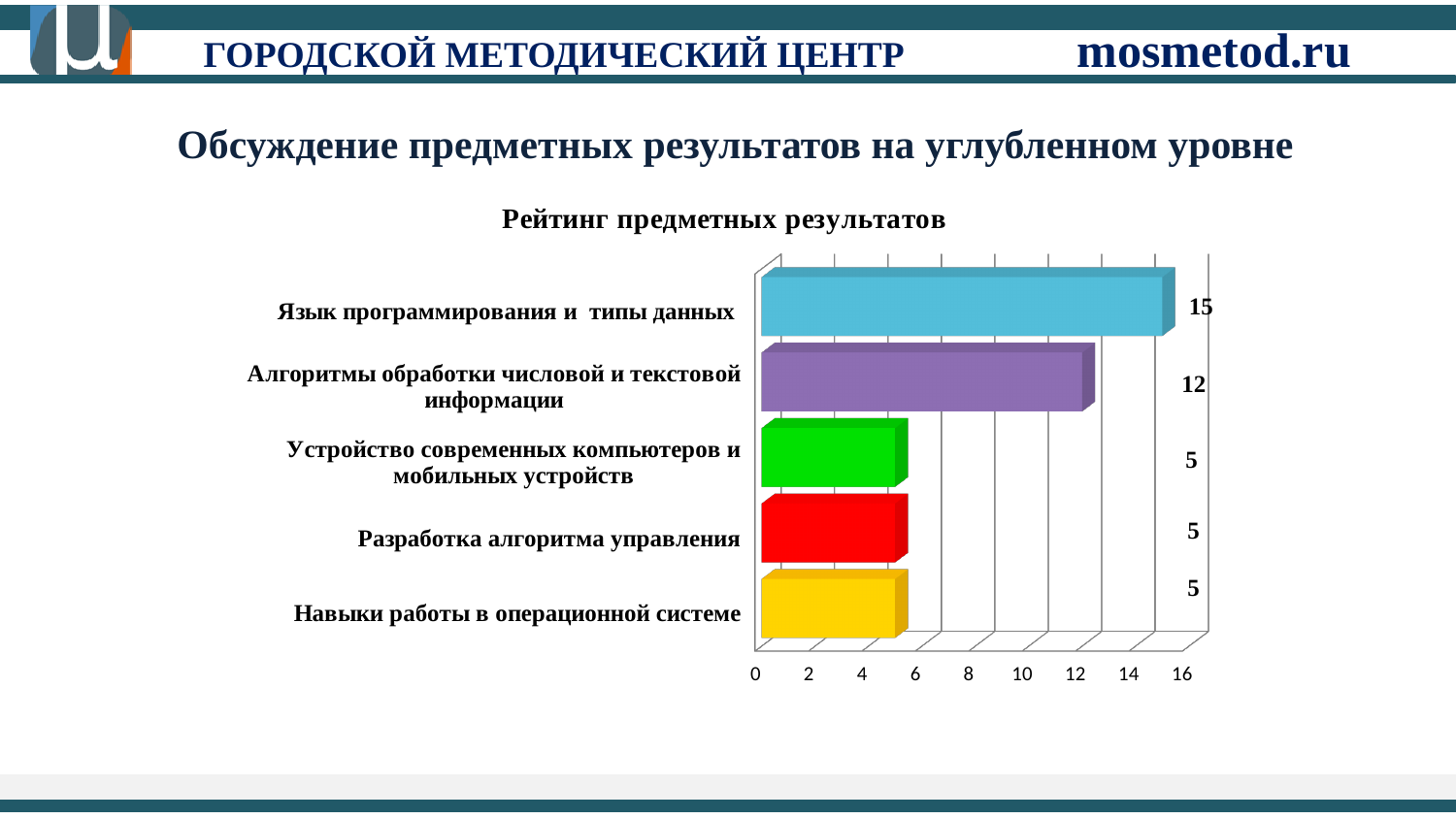
Is the value for "Язык программирования и типы данных" greater or less than 10? greater What is the title of the chart? Рейтинг предметных результатов Which category has the highest value? Язык программирования и типы данных What is the difference between the values for "Язык программирования и типы данных" and "Алгоритмы обработки числовой и текстовой информации"? 3 What is the value for "Алгоритмы обработки числовой и текстовой информации"? 12 What is the value for "Навыки работы в операционной системе"? 5 Which is larger: the value for "Алгоритмы обработки числовой и текстовой информации" or the value for "Устройство современных компьютеров и мобильных устройств"? Алгоритмы обработки числовой и текстовой информации What is the value for "Язык программирования и типы данных"? 15 What is the difference between the values for "Алгоритмы обработки числовой и текстовой информации" and "Разработка алгоритма управления"? 7 Is the value for "Разработка алгоритма управления" greater or less than 8? less What kind of chart is shown on the slide? bar chart How many categories are shown in the chart? 5